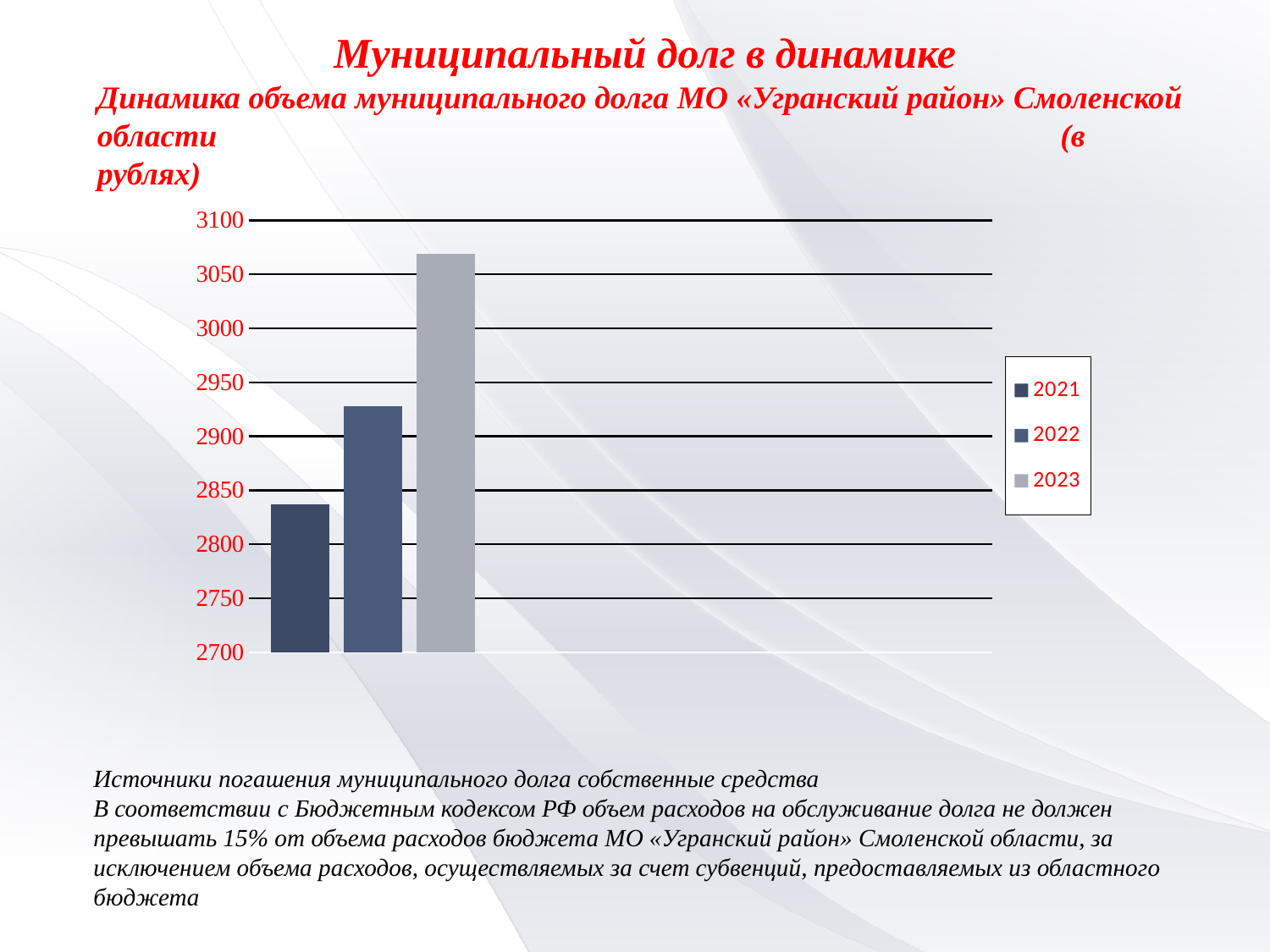
What kind of chart is shown on the slide? bar chart Is the value for 2023 greater or less than 3050? greater What are the legend entries of the chart? 2021, 2022, 2023 Do the values rise or fall from 2021 to 2023? rise How many series does the legend list? 3 How many bars are plotted in the chart? 3 What is the lowest value shown on the vertical axis? 2700 Is the value for 2022 greater or less than 2950? less Is the value for 2021 greater or less than 2800? greater Which is larger, the value for 2022 or the value for 2021? 2022 Which year has the highest municipal debt in the chart? 2023 Which year has the lowest municipal debt in the chart? 2021